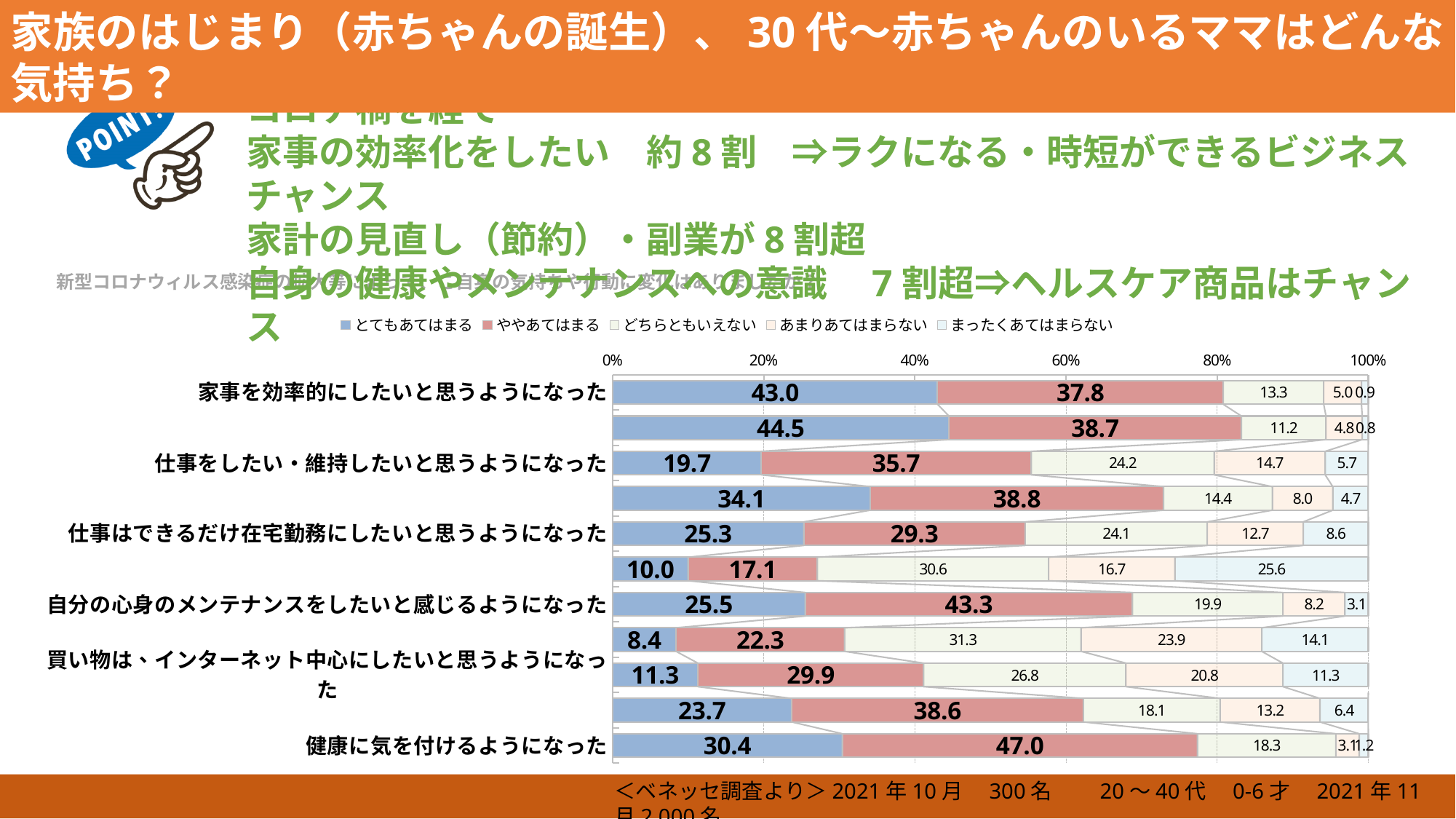
What is the まったくあてはまらない value for 仕事はできるだけ在宅勤務にしたいと思うようになった? 8.6 What is the ややあてはまる value for 健康に気を付けるようになった? 47.0 What is the total of the stacked bar for 家事を効率的にしたいと思うようになった? 100.0 What kind of chart is shown on the slide? stacked bar chart Which legend entry is shown in blue? とてもあてはまる What is the difference between the とてもあてはまる values for 家事を効率的にしたいと思うようになった and 仕事をしたい・維持したいと思うようになった? 23.3 Which has the larger とてもあてはまる value: 家事を効率的にしたいと思うようになった or 仕事をしたい・維持したいと思うようになった? 家事を効率的にしたいと思うようになった How many bars are plotted in the chart? 11 What is the どちらともいえない value for 仕事をしたい・維持したいと思うようになった? 24.2 How many series does the legend list? 5 What is the とてもあてはまる value for 家事を効率的にしたいと思うようになった? 43.0 What is the あまりあてはまらない value for 買い物は、インターネット中心にしたいと思うようになった? 20.8